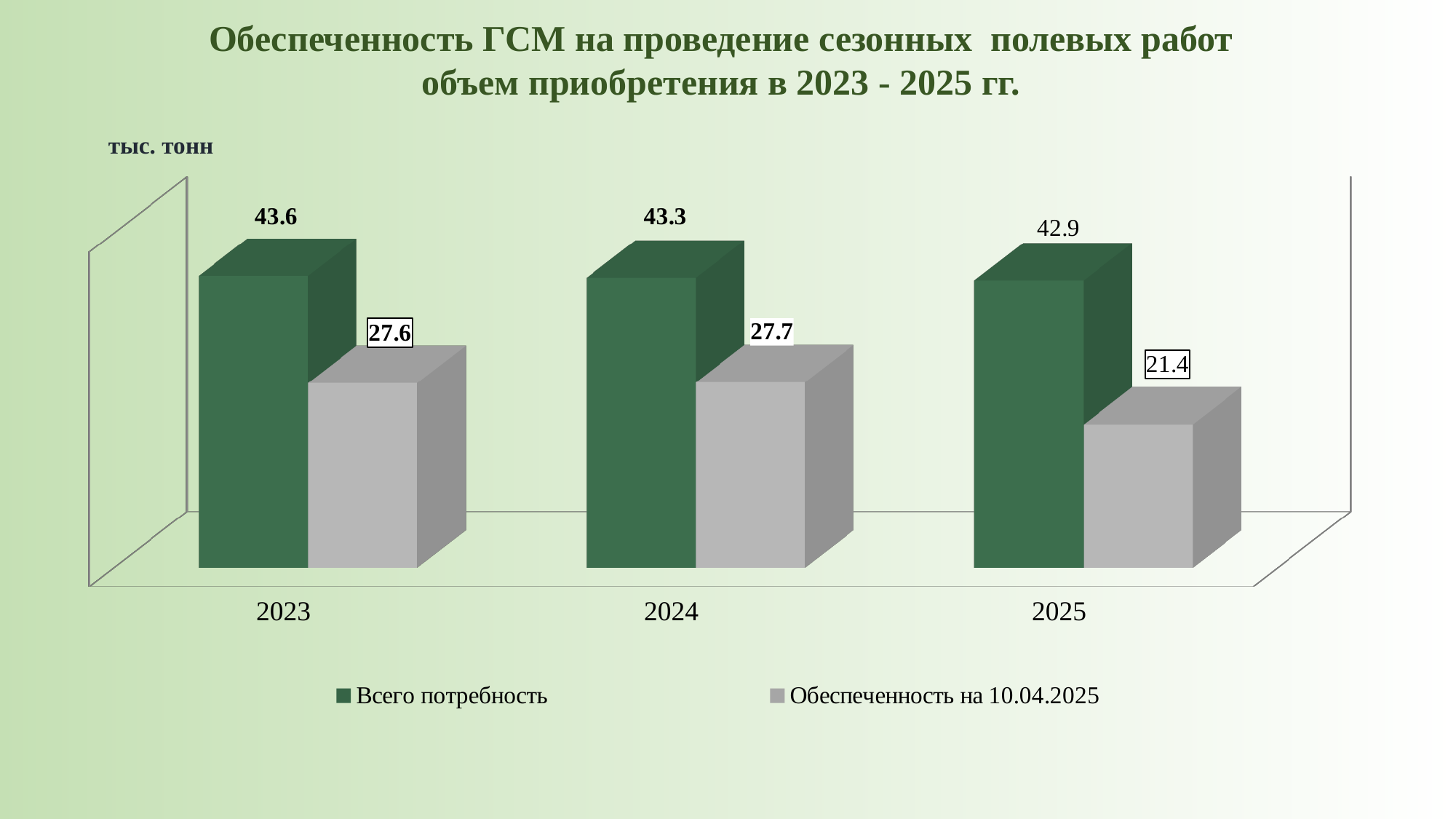
What is the value of "Обеспеченность на 10.04.2025" for 2025? 21.4 How many series does the legend list? 2 How many years are shown on the x axis? 3 Does the value of "Всего потребность" rise or fall from 2023 to 2025? fall What is the value of "Всего потребность" for 2023? 43.6 Which year has the highest value for "Всего потребность"? 2023 What is the difference between "Всего потребность" and "Обеспеченность на 10.04.2025" in 2025? 21.5 What is the value of "Обеспеченность на 10.04.2025" for 2024? 27.7 What is the difference between "Всего потребность" in 2023 and in 2025? 0.7 Which is larger: "Обеспеченность на 10.04.2025" in 2024 or in 2025? 2024 What kind of chart is shown on the slide? bar chart Which year has the lowest value for "Обеспеченность на 10.04.2025"? 2025